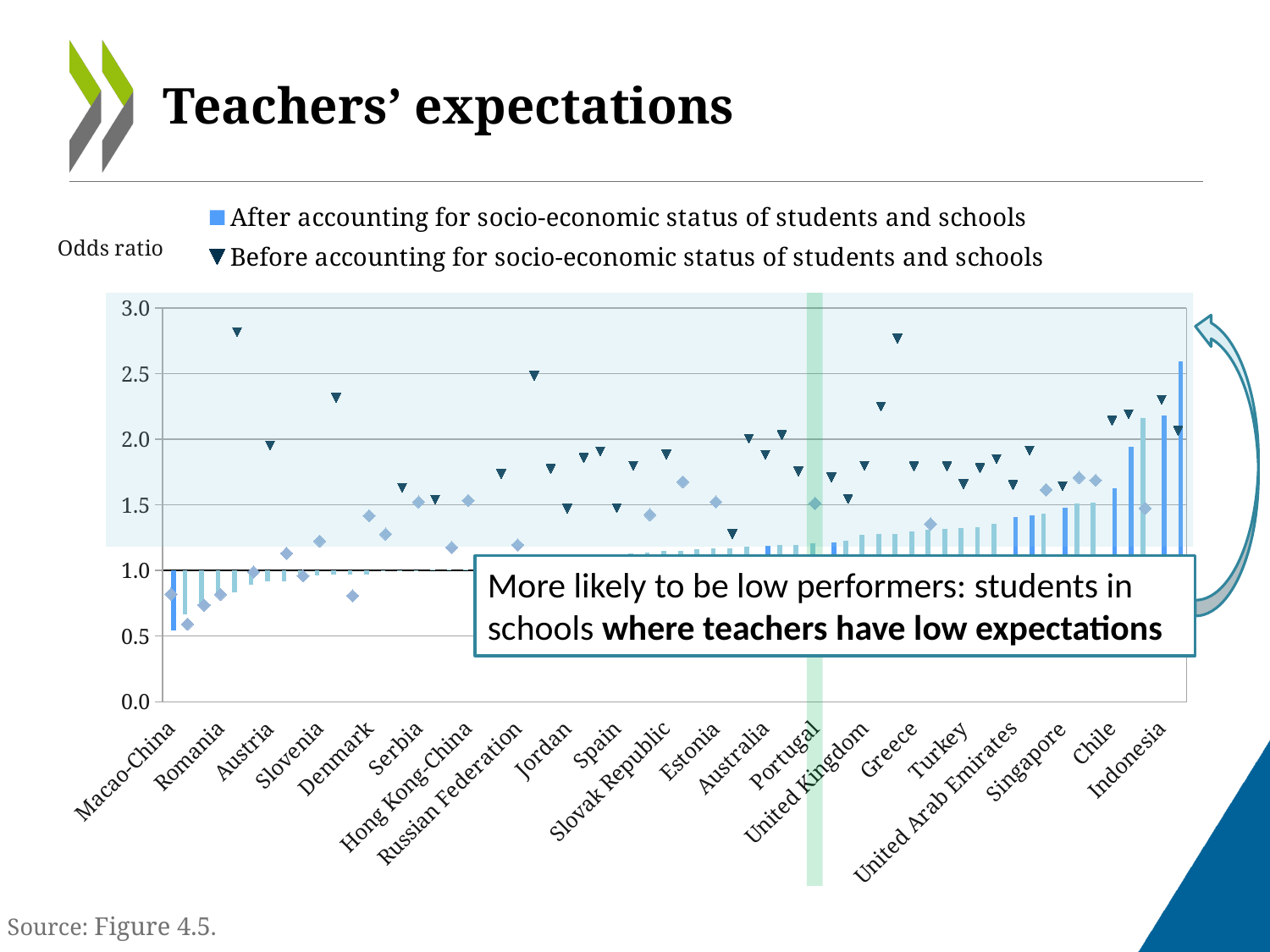
Is the 'After accounting for socio-economic status' value for Indonesia greater or less than 2.0? greater Is the 'After accounting for socio-economic status' value for Macao-China greater or less than 1.0? less Which has the larger 'After accounting for socio-economic status' value, Macao-China or Indonesia? Indonesia What is the highest value shown on the vertical axis? 3.0 How many series does the legend list? 2 What is the label on the vertical axis of the chart? Odds ratio Do the 'After accounting for socio-economic status' bars generally rise or fall from left to right along the x axis? rise What is the title of the slide containing the chart? Teachers' expectations What kind of chart is shown on the slide? bar chart